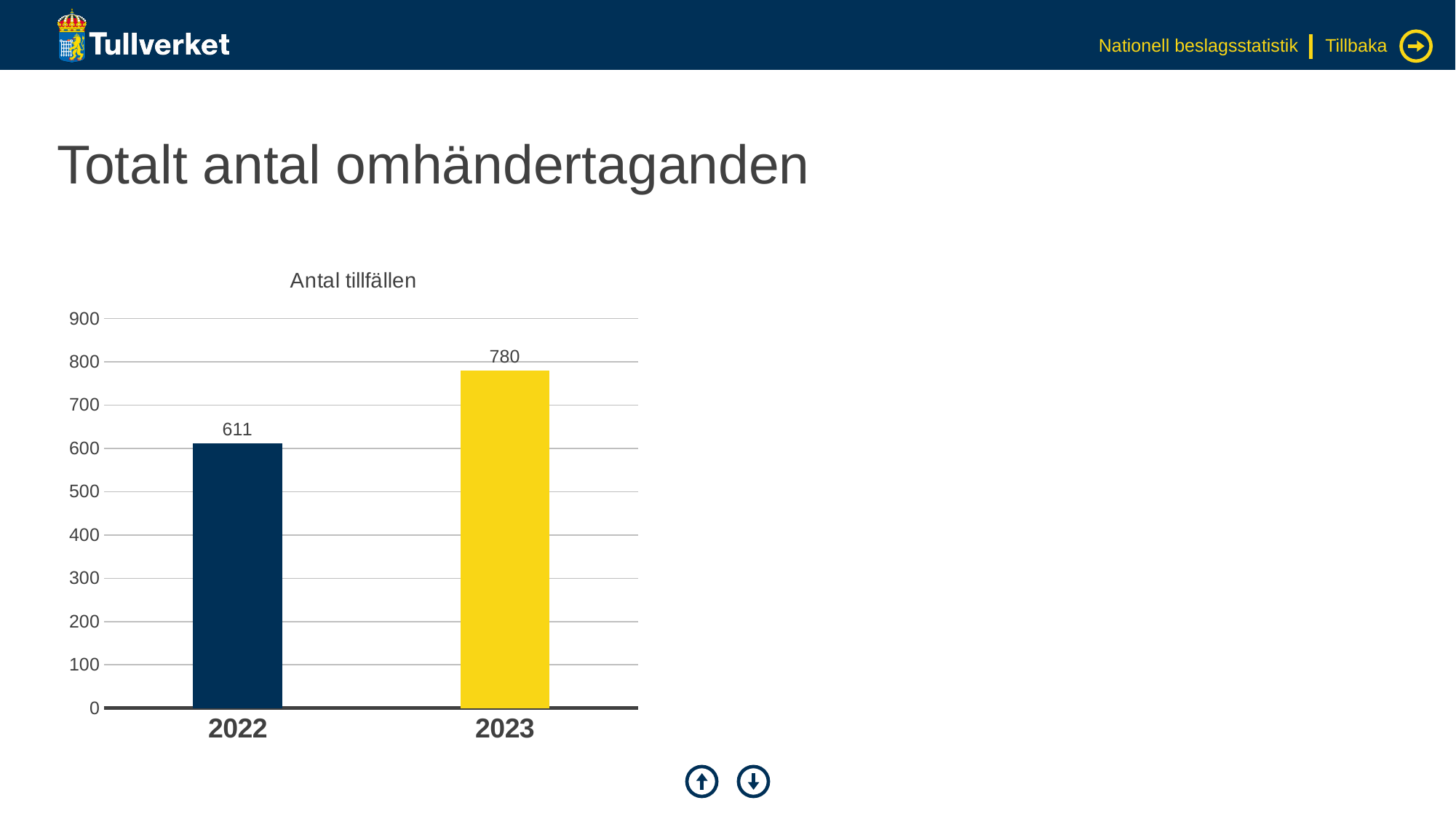
What is the value for 2023? 780 What is the value for 2022? 611 What is the difference between the values for 2023 and 2022? 169 What kind of chart is shown on the slide? bar chart Which year has the lowest value? 2022 Which year has the highest value? 2023 Which is larger, the value for 2022 or the value for 2023? 2023 Is the value for 2023 greater or less than 700? greater Do the values rise or fall from 2022 to 2023? rise What is the title of the chart? Antal tillfällen How many categories are shown on the x axis? 2 Is the value for 2022 greater or less than 700? less